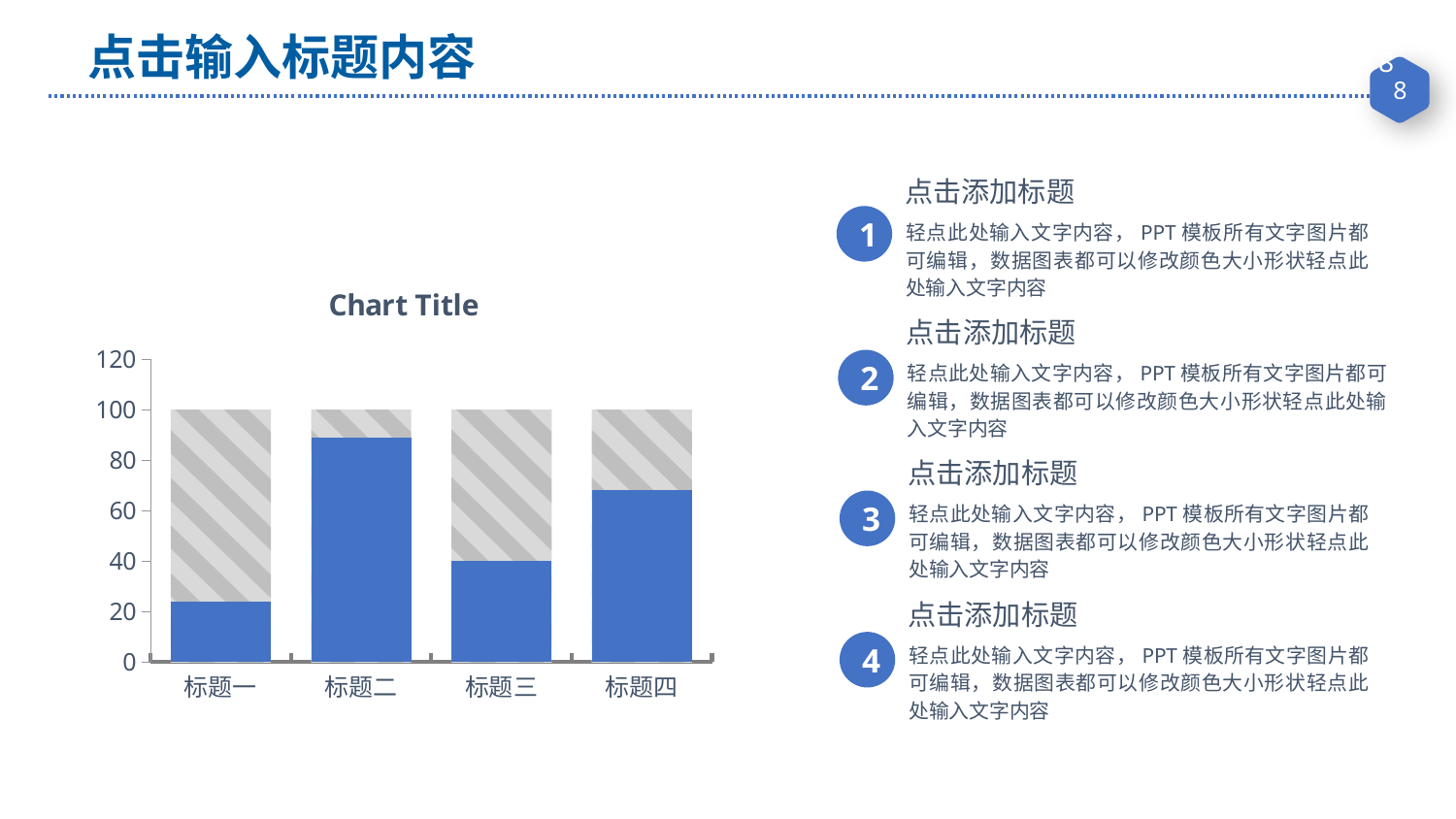
What is the title of the chart? Chart Title Is the blue segment for 标题四 greater or less than 60? greater What is the highest value shown on the vertical axis? 120 Which category has the tallest blue bar segment? 标题二 What is the total height of the stacked bar for 标题一? 100 Which has the larger blue segment, 标题二 or 标题三? 标题二 Is the blue segment for 标题三 greater or less than 60? less Is the blue segment for 标题二 greater or less than 80? greater Which category has the shortest blue bar segment? 标题一 How many categories are shown on the x axis of the chart? 4 What kind of chart is shown on the slide? bar chart